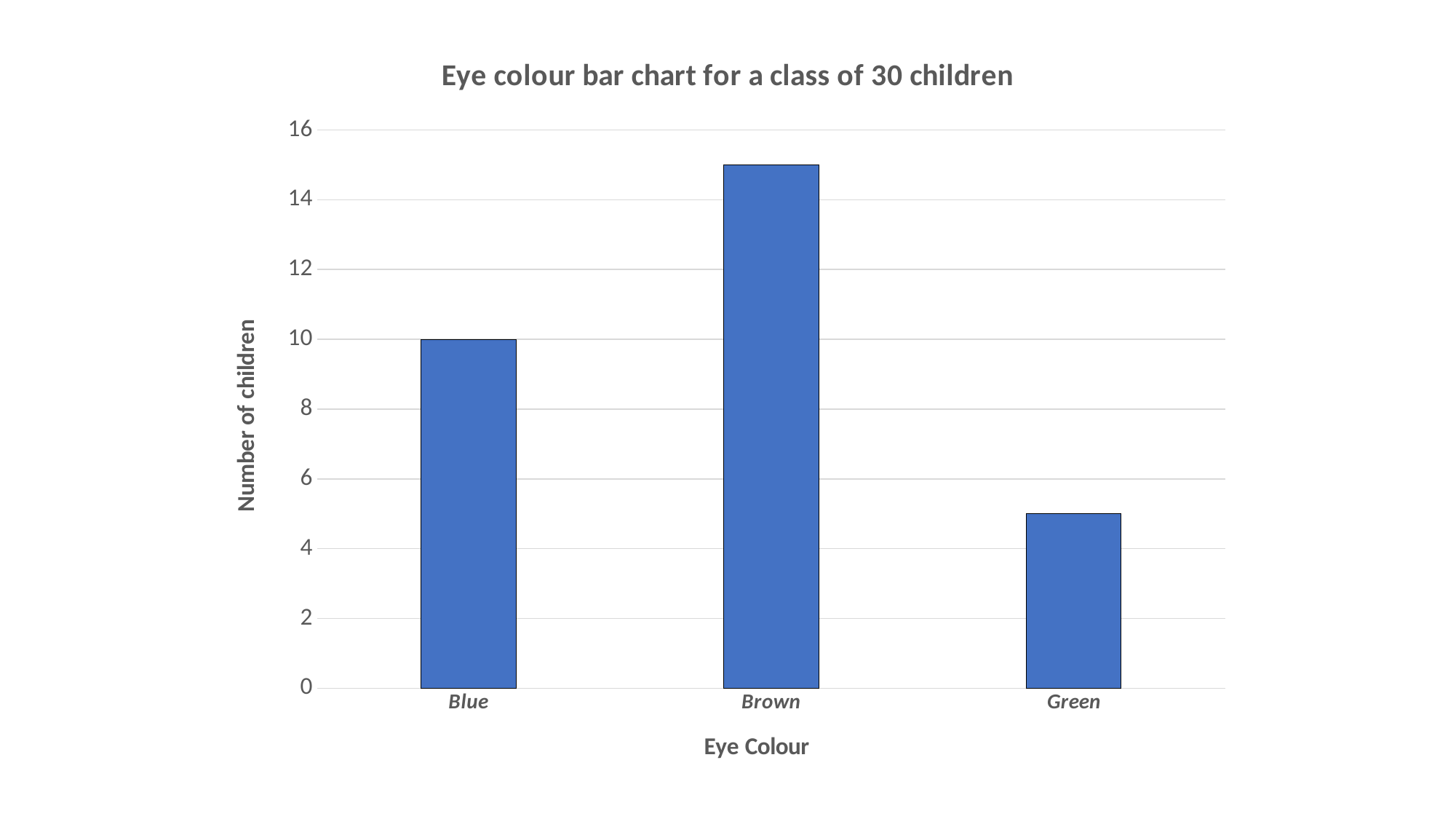
Which eye colour has the highest number of children? Brown Is the value for Brown greater or less than 14? greater Is the value for Green greater or less than 6? less Which eye colour has the lowest number of children? Green What type of chart is shown on the slide? bar chart Which has more children, Blue or Green? Blue What is the title of the chart? Eye colour bar chart for a class of 30 children How many children have blue eyes according to the chart? 10 What is the label on the vertical axis of the chart? Number of children Which has more children, Brown or Blue? Brown Is the value for Brown greater or less than 16? less How many eye colour categories are shown in the chart? 3